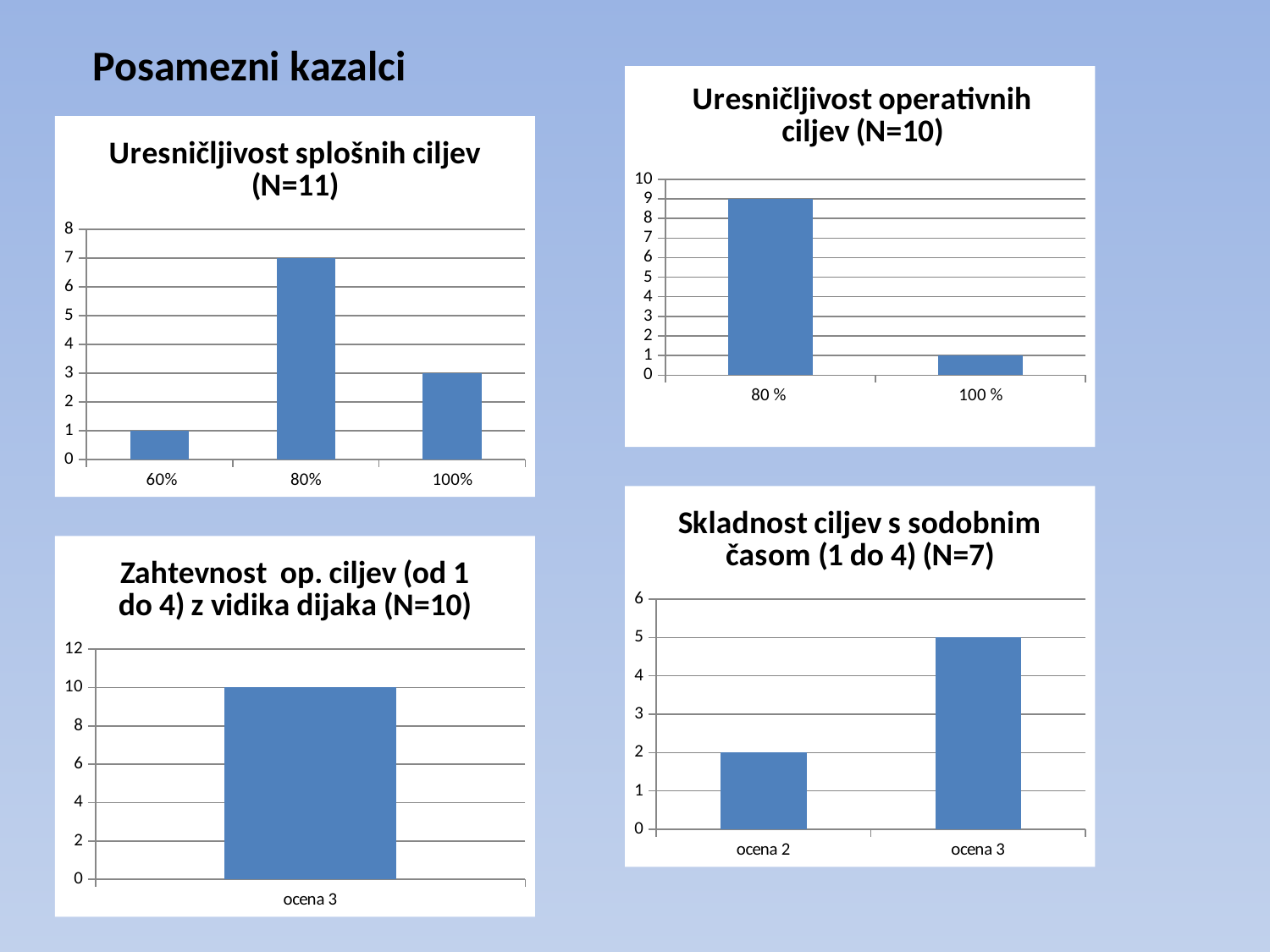
In the chart 'Skladnost ciljev s sodobnim časom (1 do 4) (N=7)', which is larger, the value for ocena 2 or ocena 3? ocena 3 In the chart 'Uresničljivost splošnih ciljev (N=11)', which category has the lowest value? 60% In the chart 'Uresničljivost splošnih ciljev (N=11)', what is the value for 80%? 7 In the chart 'Uresničljivost operativnih ciljev (N=10)', is the value for 100 % greater or less than 5? less What kind of chart is 'Skladnost ciljev s sodobnim časom (1 do 4) (N=7)'? bar chart In the chart 'Uresničljivost splošnih ciljev (N=11)', how many categories are shown on the x axis? 3 In the chart 'Uresničljivost operativnih ciljev (N=10)', which category has the highest value? 80 % In the chart 'Zahtevnost op. ciljev (od 1 do 4) z vidika dijaka (N=10)', what is the value for ocena 3? 10 In the chart 'Uresničljivost operativnih ciljev (N=10)', what is the value for 80 %? 9 In the chart 'Zahtevnost op. ciljev (od 1 do 4) z vidika dijaka (N=10)', how many bars are shown? 1 In the chart 'Uresničljivost splošnih ciljev (N=11)', what is the difference between the values for 80% and 100%? 4 In the chart 'Skladnost ciljev s sodobnim časom (1 do 4) (N=7)', what is the value for ocena 2? 2